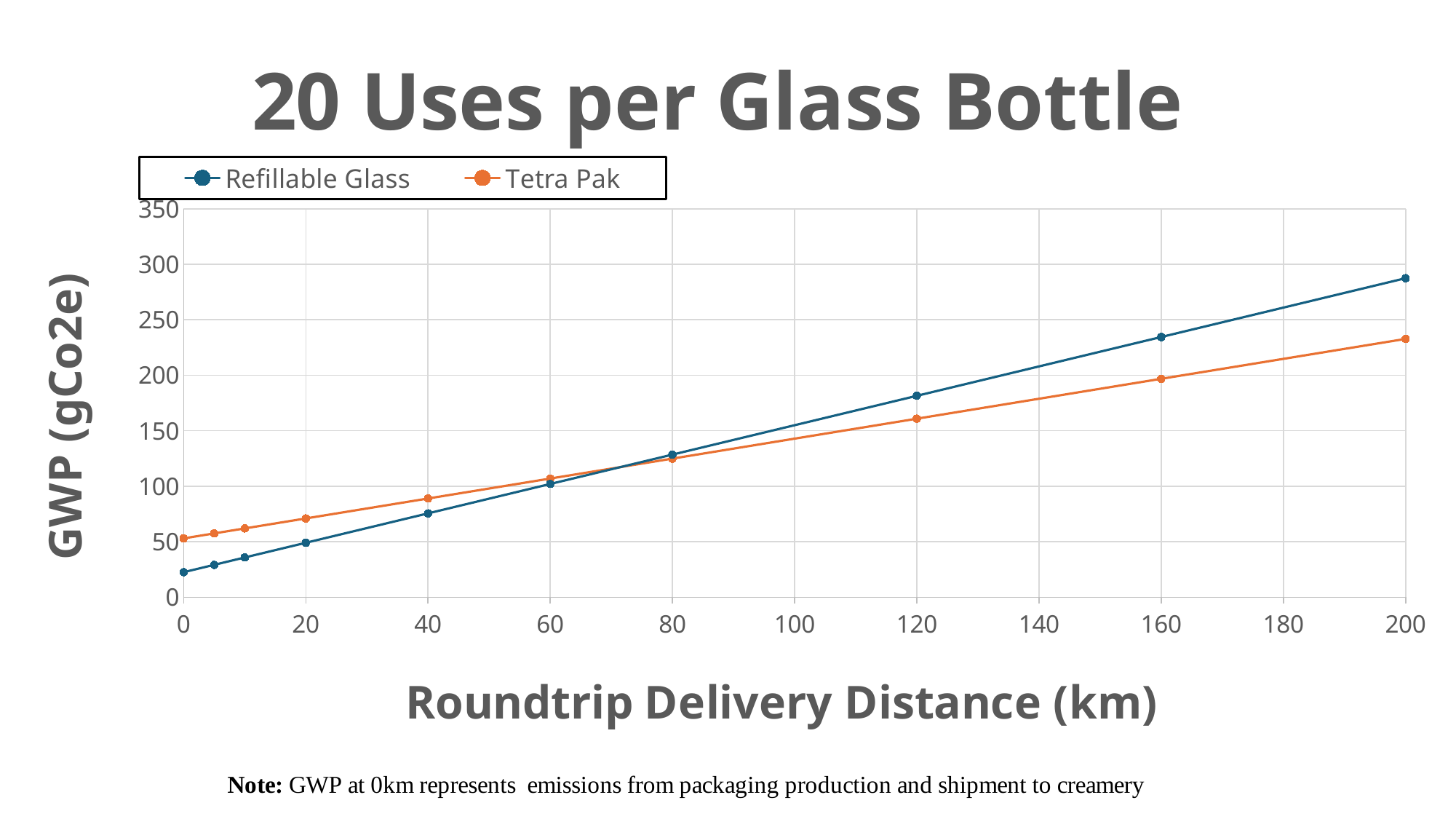
Is the GWP value for Tetra Pak at 40 km greater or less than 100? less At 200 km, which series has the higher GWP, Refillable Glass or Tetra Pak? Refillable Glass At 0 km, which series has the higher GWP, Refillable Glass or Tetra Pak? Tetra Pak Is the GWP value for Tetra Pak at 200 km greater or less than 250? less How many data points are plotted for the Refillable Glass series? 10 Do the GWP values for Refillable Glass rise or fall as roundtrip delivery distance increases? Rise Is the GWP value for Refillable Glass at 0 km greater or less than 50? less What are the two series named in the legend? Refillable Glass and Tetra Pak What is the title of the chart? 20 Uses per Glass Bottle How many series does the legend list? 2 What kind of chart is shown on the slide? Line chart